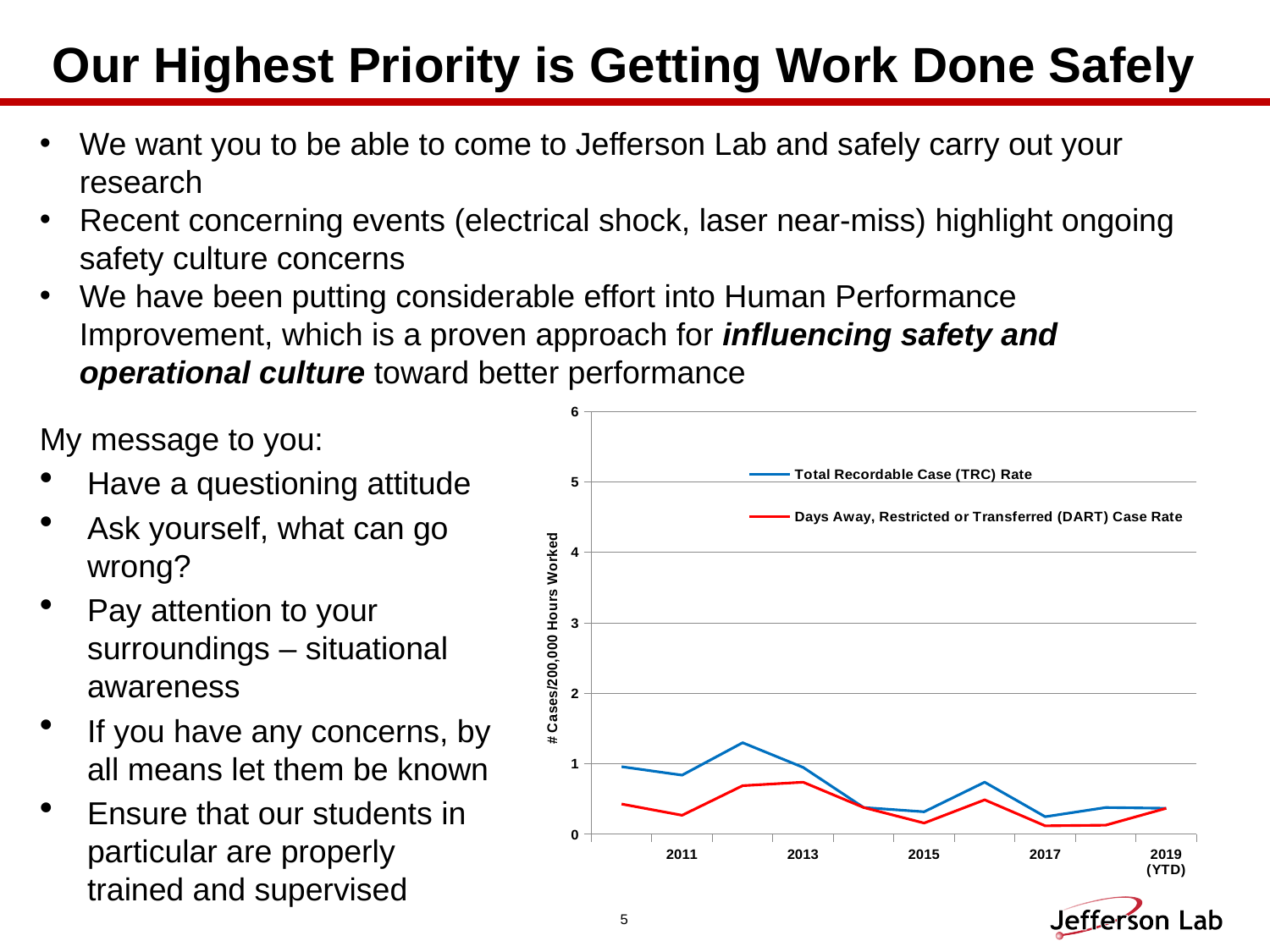
How many series does the chart's legend list? 2 In 2011, which series has the higher value: TRC Rate or DART Case Rate? Total Recordable Case (TRC) Rate Is the Total Recordable Case (TRC) Rate in 2015 greater or less than 1? less What kind of chart is shown on the slide? line chart What are the two series named in the chart's legend? Total Recordable Case (TRC) Rate; Days Away, Restricted or Transferred (DART) Case Rate In 2015, which series has the higher value: TRC Rate or DART Case Rate? Total Recordable Case (TRC) Rate Is the Days Away, Restricted or Transferred (DART) Case Rate in 2011 greater or less than 1? less Is the Total Recordable Case (TRC) Rate in 2011 greater or less than 1? less What is the label on the chart's vertical axis? # Cases/200,000 Hours Worked Does the Total Recordable Case (TRC) Rate rise or fall from 2013 to 2015? fall How many year labels are printed along the chart's x axis? 5